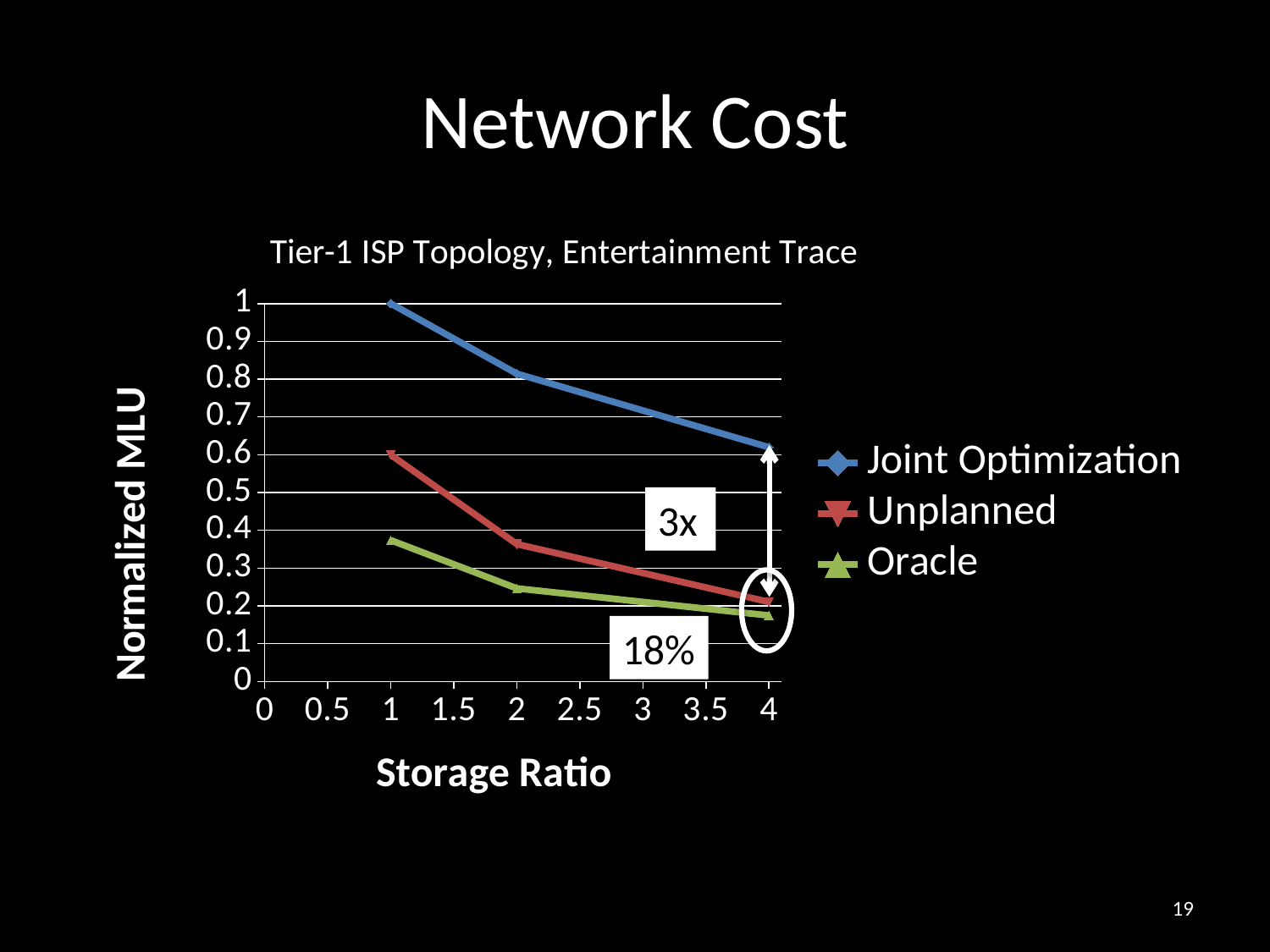
Does the Joint Optimization line rise or fall as the storage ratio increases? fall What kind of chart is shown on the slide? line chart Is the value for Oracle at a storage ratio of 1 greater or less than 0.5? less Which series has the highest Normalized MLU at a storage ratio of 1? Joint Optimization Which series has the lowest Normalized MLU at a storage ratio of 2? Oracle Is the value for Unplanned at a storage ratio of 4 greater or less than 0.3? less What is the title shown above the chart? Tier-1 ISP Topology, Entertainment Trace What is the Normalized MLU for Joint Optimization at a storage ratio of 1? 1 How many data points are plotted for the Oracle series? 3 At a storage ratio of 4, which is larger: Joint Optimization or Oracle? Joint Optimization Is the value for Joint Optimization at a storage ratio of 2 greater or less than 0.7? greater How many series does the legend list? 3